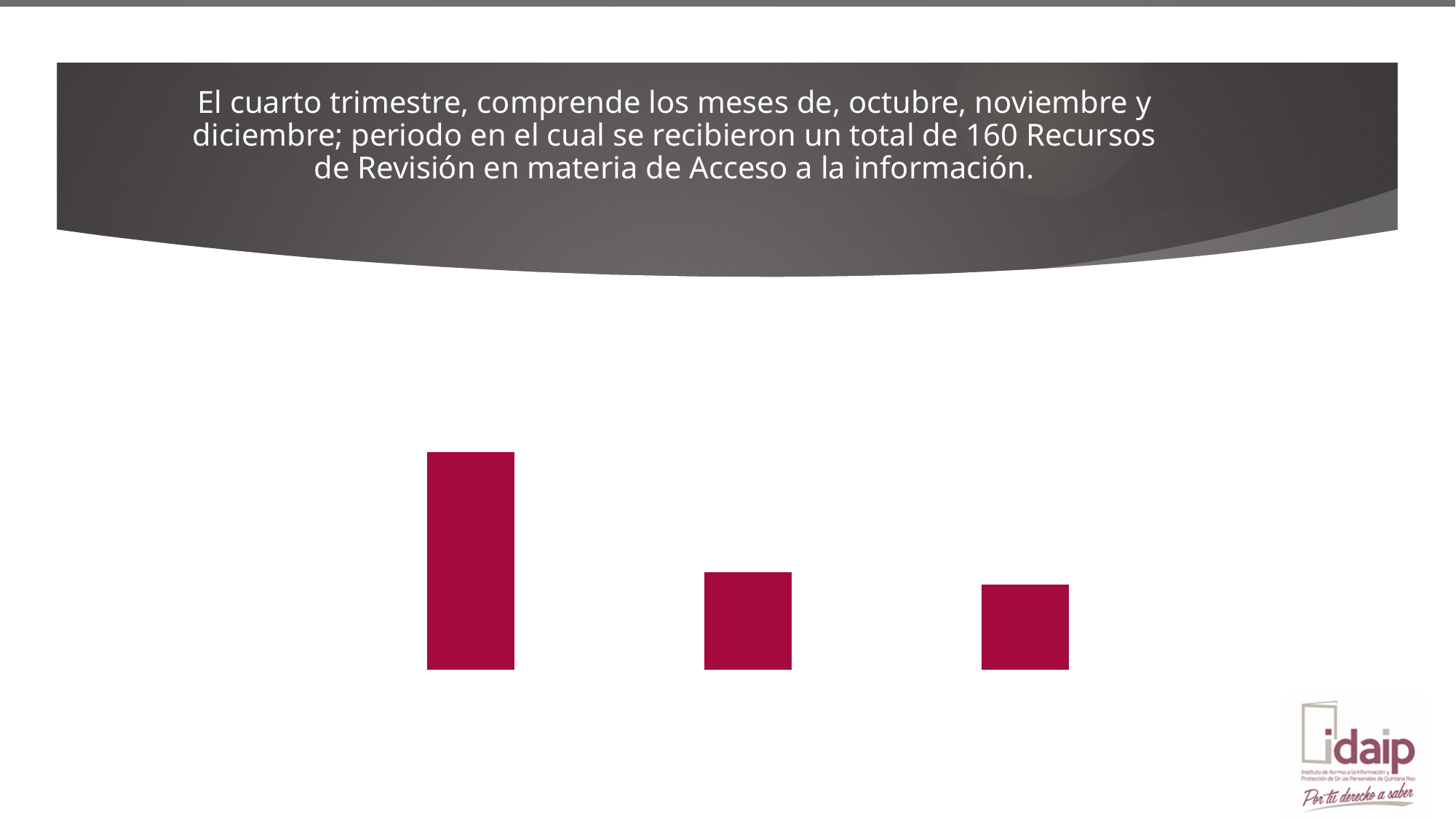
Which is taller, the middle bar or the right bar? the middle bar Which bar in the chart is the tallest: the left, middle or right one? left What colour are the bars in the chart? dark red Which is taller, the left bar or the middle bar? the left bar Which bar in the chart is the shortest: the left, middle or right one? right How many bars does the chart on the slide have? 3 What kind of chart is shown on the slide? bar chart Does the chart display a legend? No Do the bar heights rise or fall from left to right across the chart? fall